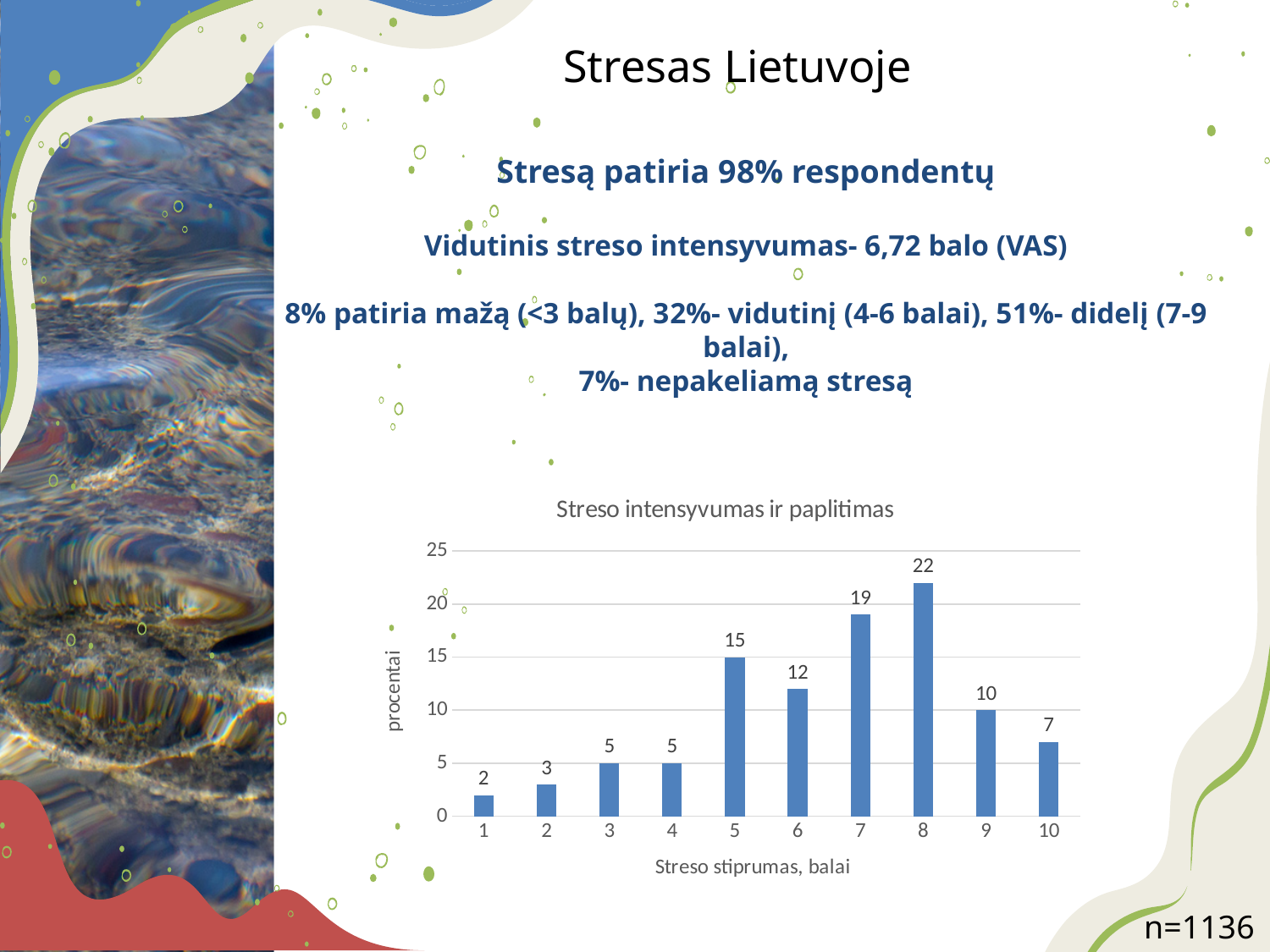
Which is larger, the value for stress level 6 or stress level 9? 6 Do the values rise or fall from stress level 8 to stress level 10? fall Which stress level has the highest percentage in the chart? 8 How many categories are shown on the x axis of the chart? 10 What is the title of the chart? Streso intensyvumas ir paplitimas What kind of chart is shown on the slide? bar chart What is the label of the y axis of the chart? procentai What is the value for stress level 1 in the chart? 2 What is the value for stress level 8 in the chart? 22 What is the difference between the values for stress levels 8 and 7? 3 Which stress level has the lowest percentage in the chart? 1 What is the value for stress level 5 in the chart? 15